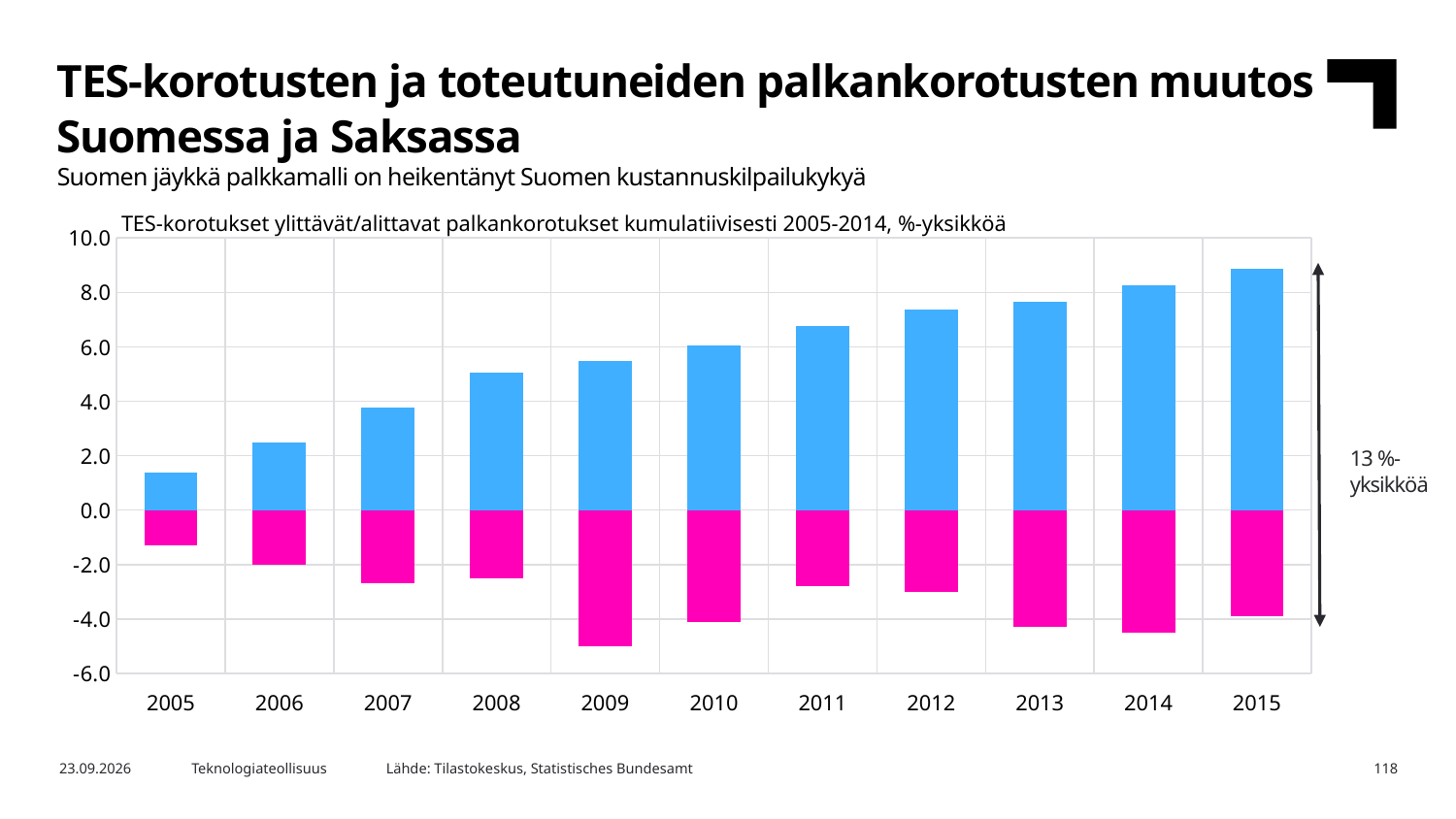
Is the magenta bar value for 2009 greater or less than -4.0? less Do the blue bars rise or fall from 2005 to 2015? rise Which year has the larger blue bar, 2008 or 2012? 2012 Which year has the tallest blue (positive) bar? 2015 What is the chart's title? TES-korotukset ylittävät/alittavat palkankorotukset kumulatiivisesti 2005-2014, %-yksikköä How many years are shown on the x axis of the chart? 11 Is the blue bar value for 2010 greater or less than 4.0? greater What kind of chart is shown on the slide? bar chart Which year has the shortest blue (positive) bar? 2005 What value does the arrow annotation to the right of the chart indicate? 13 %-yksikköä Is the blue bar value for 2005 greater or less than 2.0? less Which year has the longest magenta (negative) bar? 2009